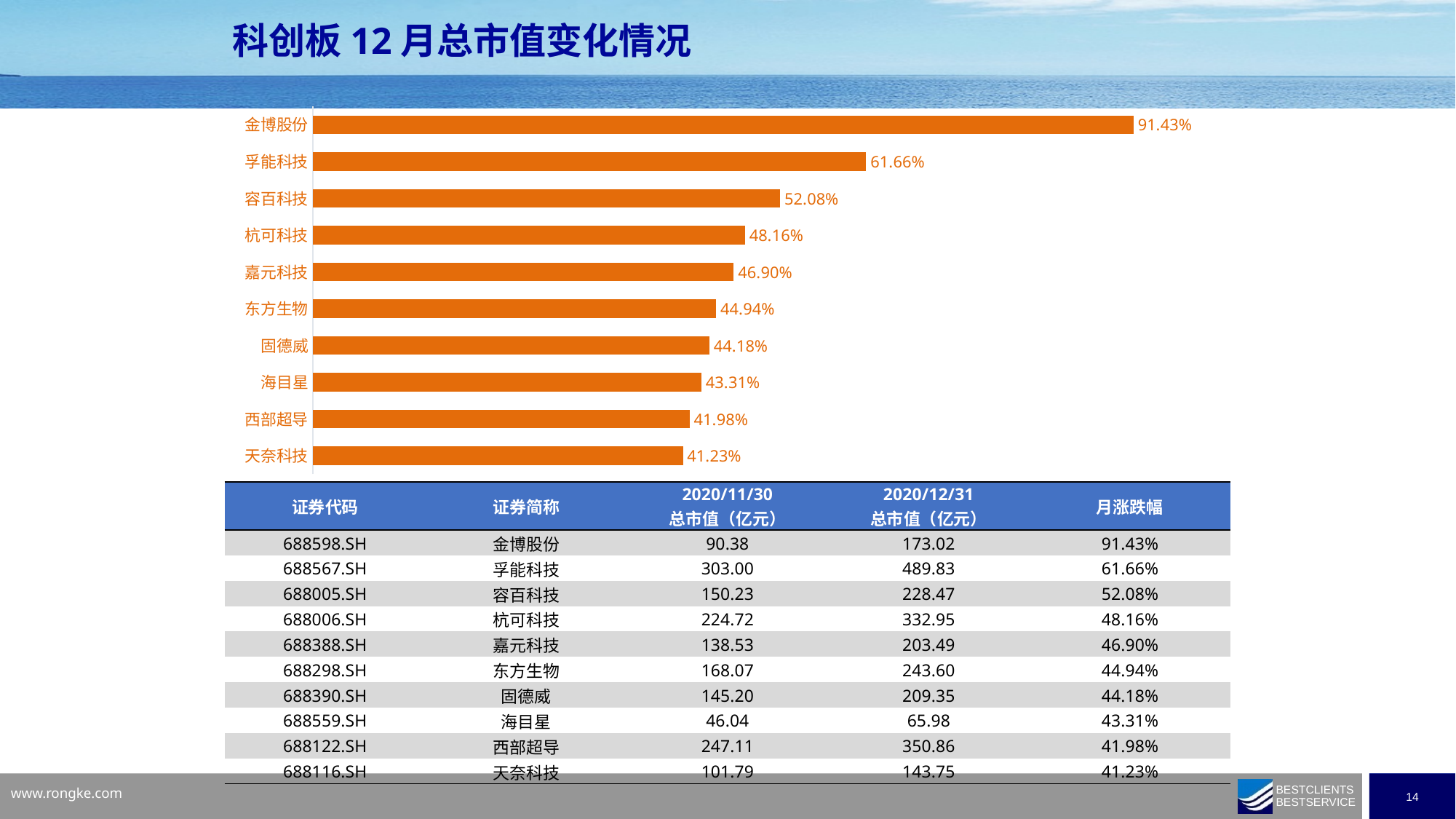
What is the value shown for 海目星 in the bar chart? 43.31% What is the value shown for 天奈科技 in the bar chart? 41.23% What is the difference between the values for 容百科技 and 杭可科技 in the bar chart? 3.92% What is the difference between the values for 金博股份 and 孚能科技 in the bar chart? 29.77% What is the title of the slide containing the chart? 科创板 12 月总市值变化情况 Which category has the lowest value in the bar chart? 天奈科技 What is the value shown for 金博股份 in the bar chart? 91.43% How many categories are shown in the bar chart? 10 Which has a larger value in the bar chart, 嘉元科技 or 东方生物? 嘉元科技 Which category has the highest value in the bar chart? 金博股份 What is the value shown for 孚能科技 in the bar chart? 61.66% What kind of chart is shown on the slide? Bar chart